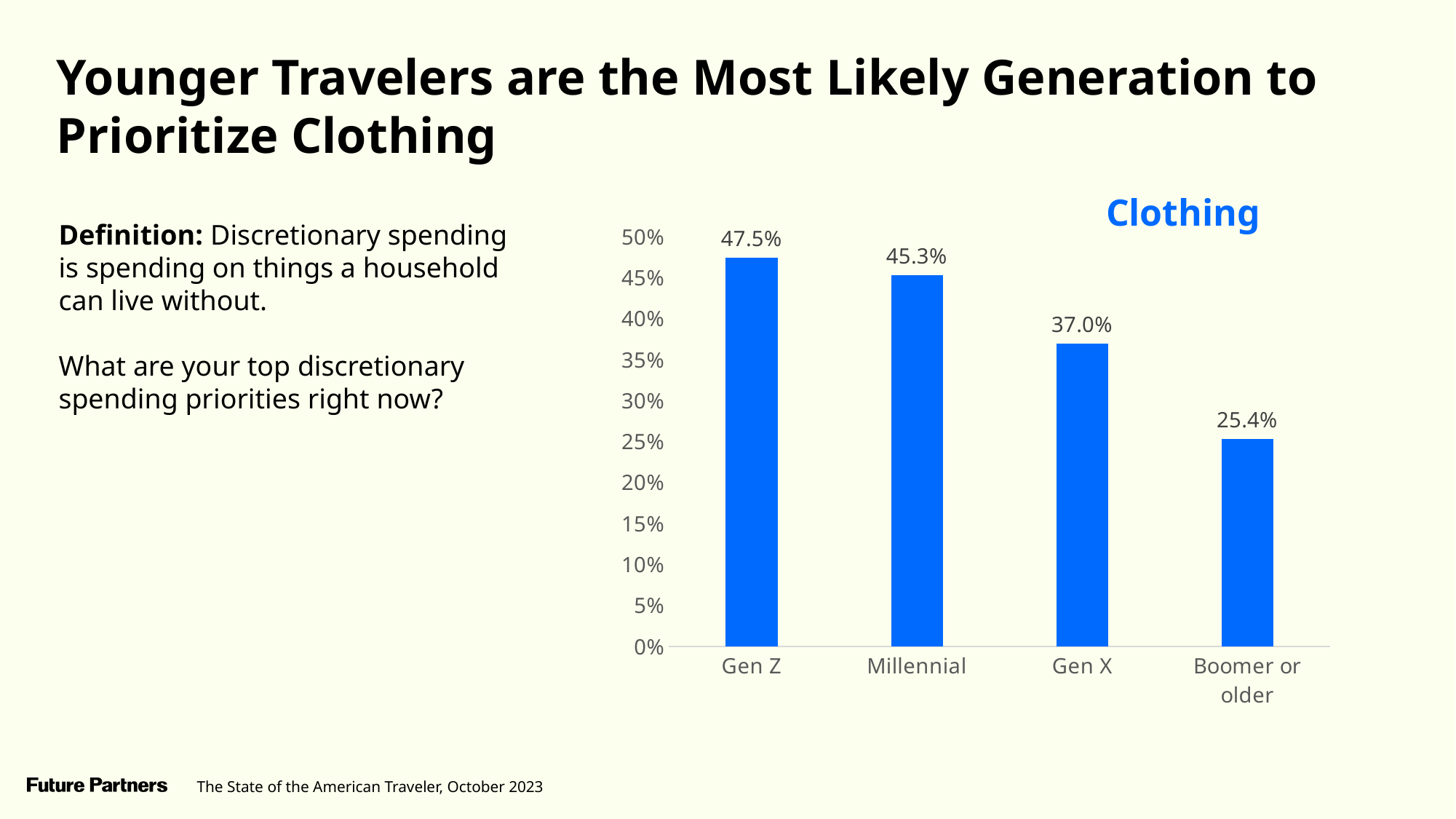
Do the values rise or fall from Gen Z to Boomer or older along the x axis? Fall Which generation has the lowest value? Boomer or older What is the value for Gen Z? 47.5% What is the difference between the values for Millennial and Gen X? 8.3% What kind of chart is shown on the slide? Bar chart Which generation has the highest value? Gen Z Which is larger, the value for Gen X or the value for Boomer or older? Gen X What is the value for Gen X? 37.0% What is the difference between the values for Gen Z and Boomer or older? 22.1% What is the value for Millennial? 45.3% How many generation categories are shown in the chart? 4 What is the value for Boomer or older? 25.4%